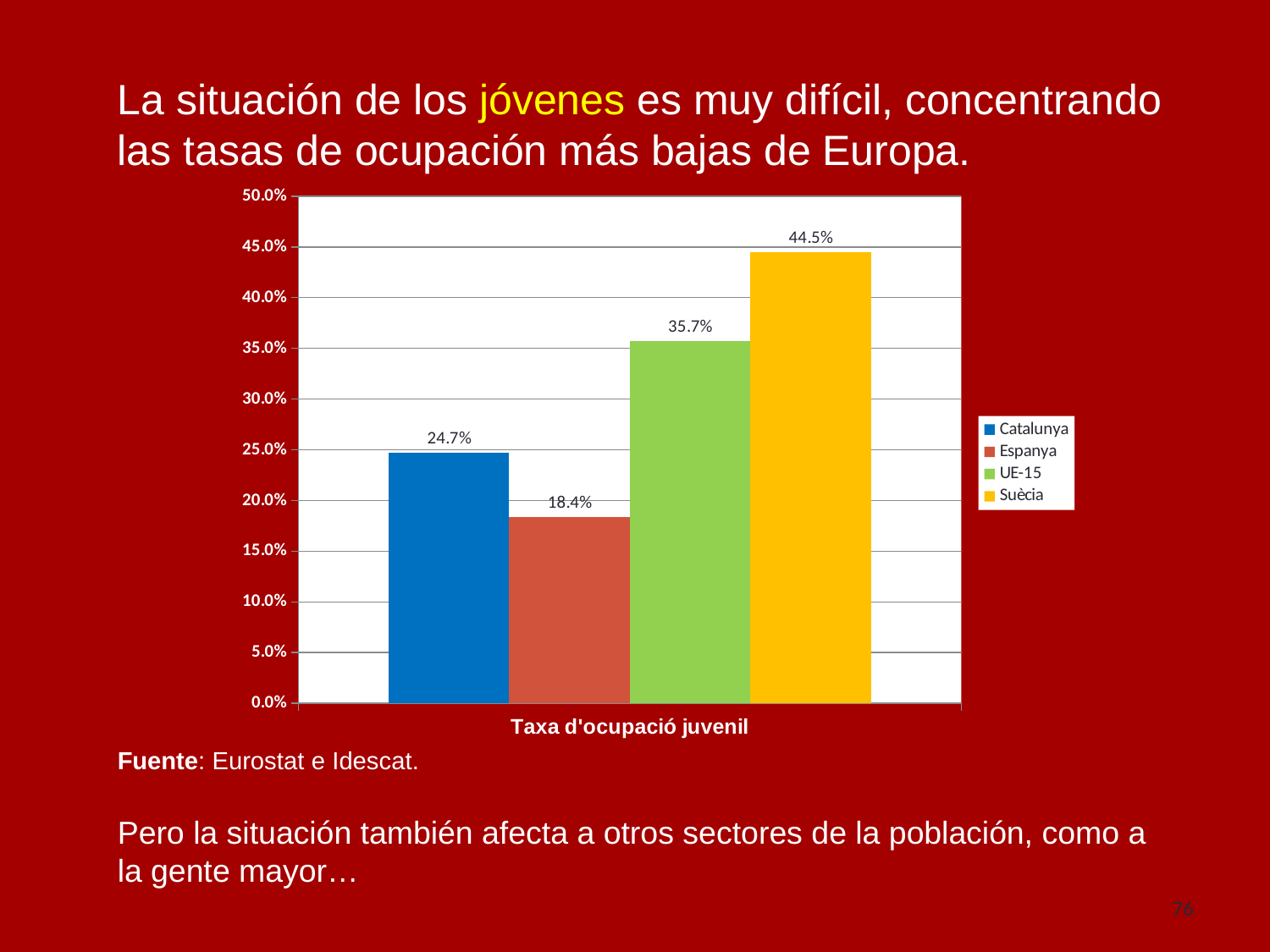
What is the youth employment rate shown for Suècia? 44.5% What is the difference between the youth employment rates of Suècia and Espanya? 26.1% What is the youth employment rate shown for UE-15? 35.7% Which series has the lowest youth employment rate? Espanya What is the youth employment rate (Taxa d'ocupació juvenil) for Catalunya? 24.7% What kind of chart is shown on the slide? Bar chart What colour is the bar for Suècia? Yellow What is the youth employment rate shown for Espanya? 18.4% Which has a higher youth employment rate, Catalunya or Espanya? Catalunya What is the difference between the youth employment rates of UE-15 and Catalunya? 11.0% Which series has the highest youth employment rate? Suècia How many series does the legend list? 4